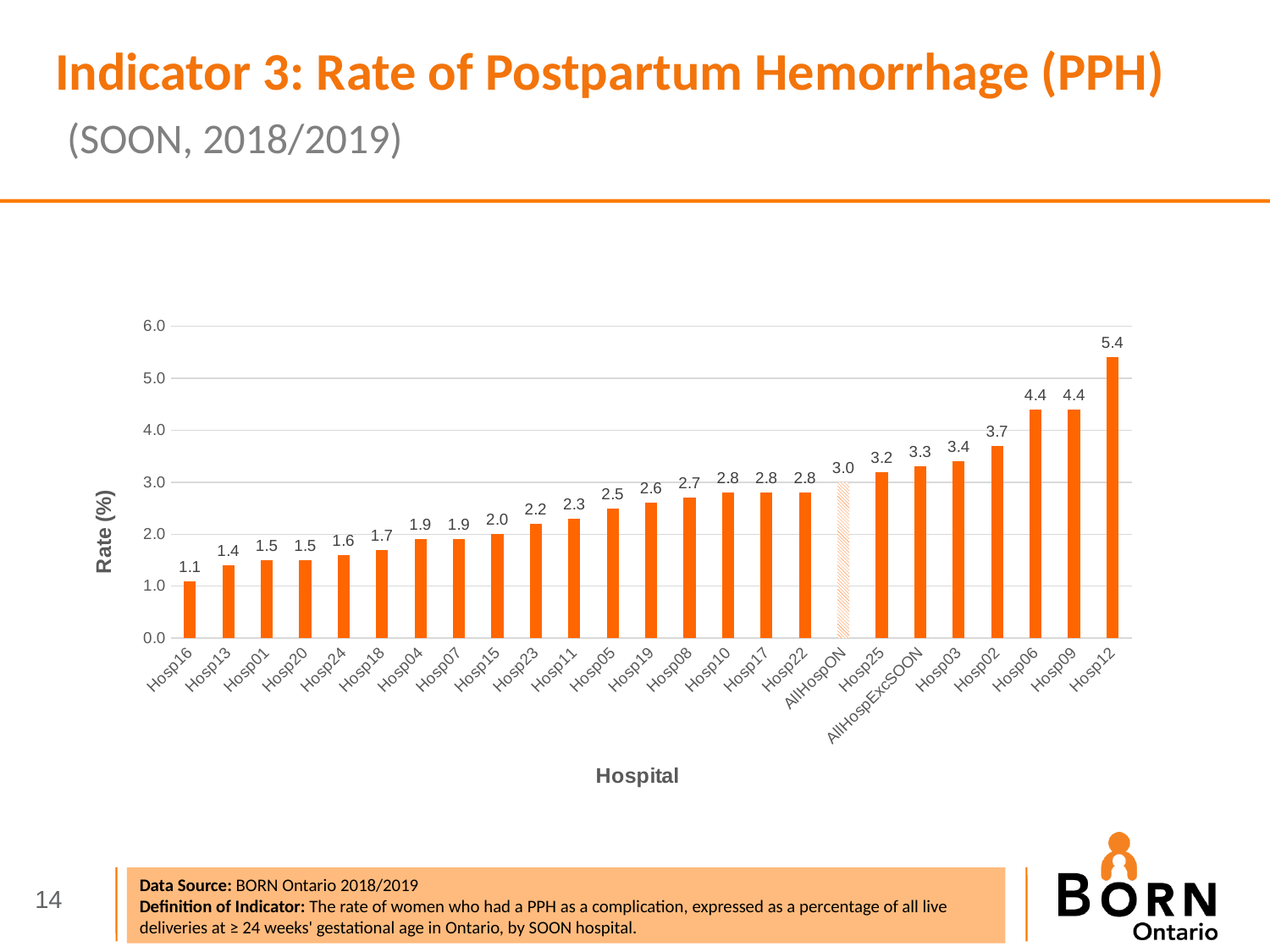
What is the difference between the PPH rate for Hosp12 and the PPH rate for Hosp16? 4.3 Do the values rise or fall from left to right along the x axis? Rise What is the difference between the PPH rate for Hosp02 and the PPH rate for AllHospON? 0.7 What is the PPH rate for Hosp12? 5.4 How many bars are shown on the chart? 25 Which hospital has the lowest PPH rate? Hosp16 What kind of chart is shown on the slide? Bar chart What is the PPH rate for Hosp03? 3.4 Which has a higher PPH rate, Hosp25 or Hosp05? Hosp25 What is the PPH rate for AllHospExcSOON? 3.3 Which hospital has the highest PPH rate? Hosp12 What is the PPH rate for AllHospON? 3.0